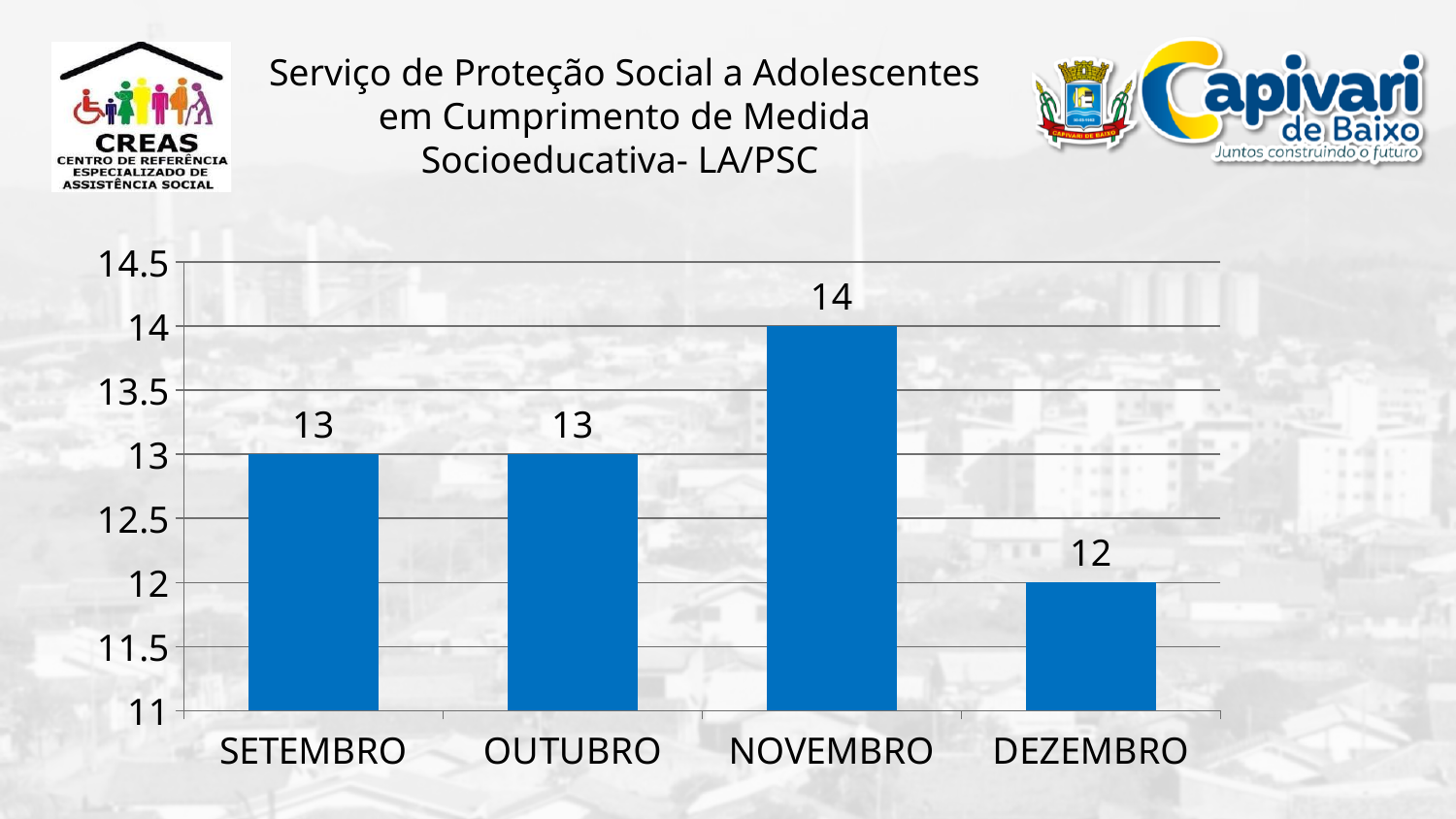
What is the difference between the values for NOVEMBRO and DEZEMBRO? 2 Which is larger, the value for OUTUBRO or the value for DEZEMBRO? OUTUBRO What is the value for DEZEMBRO? 12 What is the value for NOVEMBRO? 14 Does the value rise or fall from NOVEMBRO to DEZEMBRO? fall What kind of chart is shown on the slide? bar chart What is the value for SETEMBRO? 13 Is the value for DEZEMBRO greater or less than 13? less How many months are shown on the x axis? 4 Which month has the lowest value? DEZEMBRO What is the title of the slide? Serviço de Proteção Social a Adolescentes em Cumprimento de Medida Socioeducativa- LA/PSC Which month has the highest value? NOVEMBRO